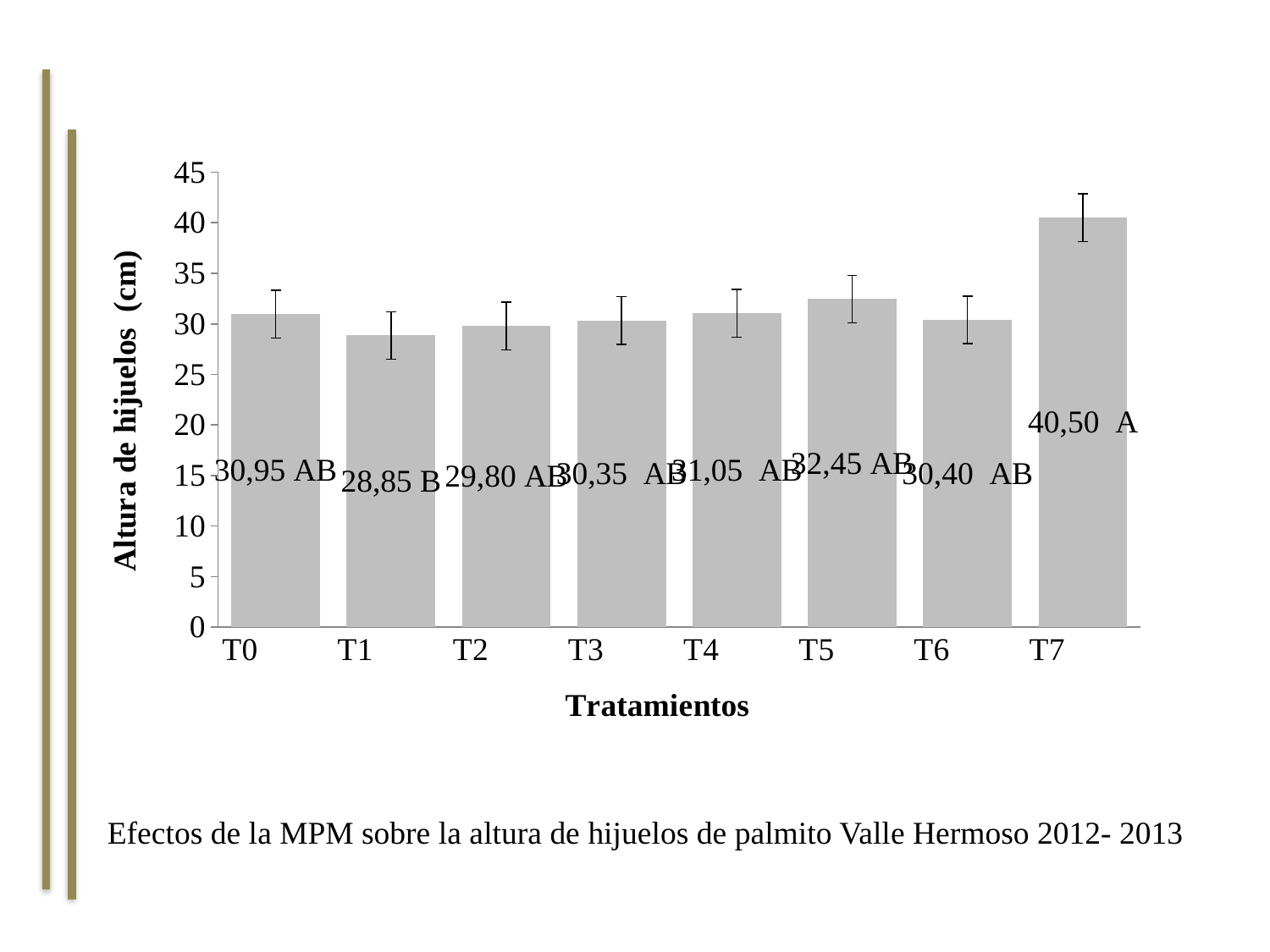
What kind of chart is shown on the slide? bar chart What is the title of the vertical axis? Altura de hijuelos (cm) Which is larger, the value for T5 or the value for T4? T5 What is the value for T7? 40,50 What is the value for T5? 32,45 How many treatments are shown on the x axis? 8 What is the difference between the values for T7 and T1? 11,65 What is the difference between the values for T5 and T0? 1,50 Is the value for T7 greater or less than 35? greater What is the value for T1? 28,85 Which treatment has the lowest value? T1 Which treatment has the highest value? T7